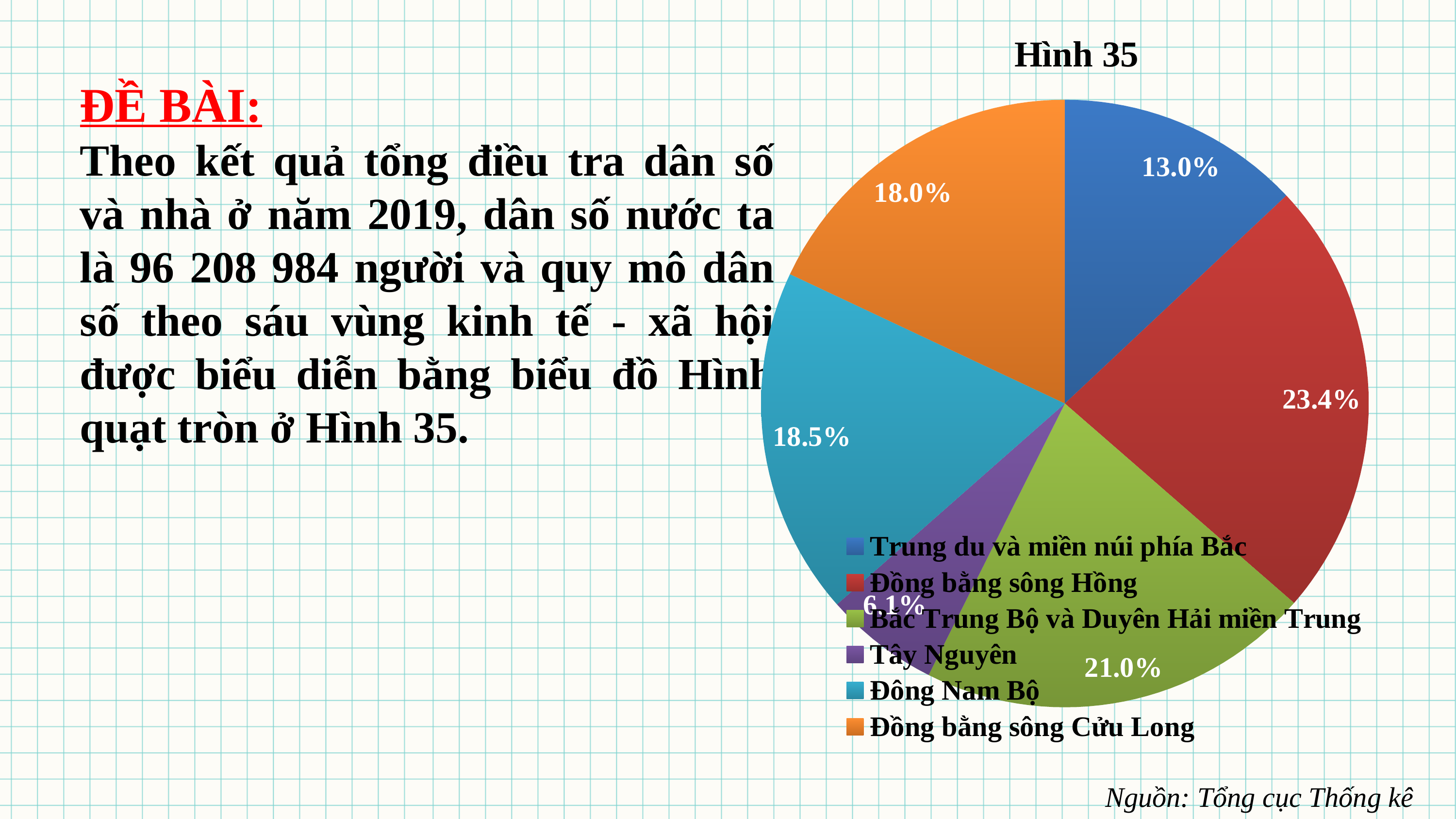
What is the value shown for Tây Nguyên? 6.1% What is the value shown for Đông Nam Bộ? 18.5% Which region has the smallest slice of the pie? Tây Nguyên What colour is the slice for Bắc Trung Bộ và Duyên Hải miền Trung? Green What is the difference between the shares of Đồng bằng sông Hồng and Bắc Trung Bộ và Duyên Hải miền Trung? 2.4% Which is larger, the share of Đông Nam Bộ or the share of Trung du và miền núi phía Bắc? Đông Nam Bộ What is the value shown for Đồng bằng sông Cửu Long? 18.0% Which region has the largest slice of the pie? Đồng bằng sông Hồng How many regions are shown in the pie chart? 6 What share of the pie does Đồng bằng sông Hồng have? 23.4% What kind of chart is shown in Hình 35? Pie chart What is the value shown for Trung du và miền núi phía Bắc? 13.0%